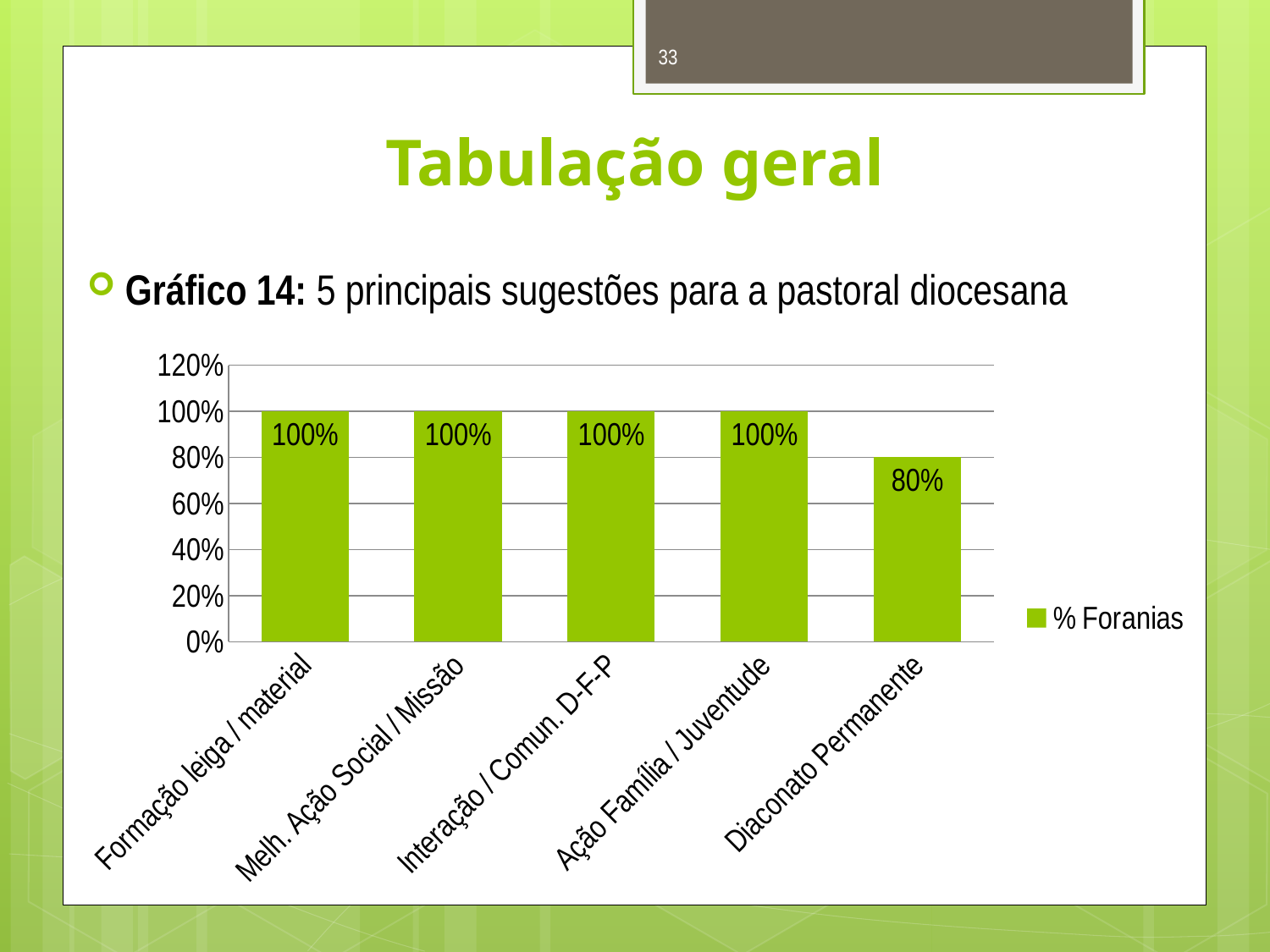
How many series does the legend list? 1 What is the value for Ação Família / Juventude? 100% What is the value for Formação leiga / material? 100% What is the difference between the values for Melh. Ação Social / Missão and Diaconato Permanente? 20% What is the name of the series in the legend? % Foranias What is the value for Diaconato Permanente? 80% How many categories have a value of 100%? 4 Is the value for Diaconato Permanente greater or less than 60%? greater How many categories are shown on the x axis? 5 What kind of chart is shown? bar chart Which is larger, the value for Interação / Comun. D-F-P or the value for Diaconato Permanente? Interação / Comun. D-F-P Which category has the lowest value? Diaconato Permanente